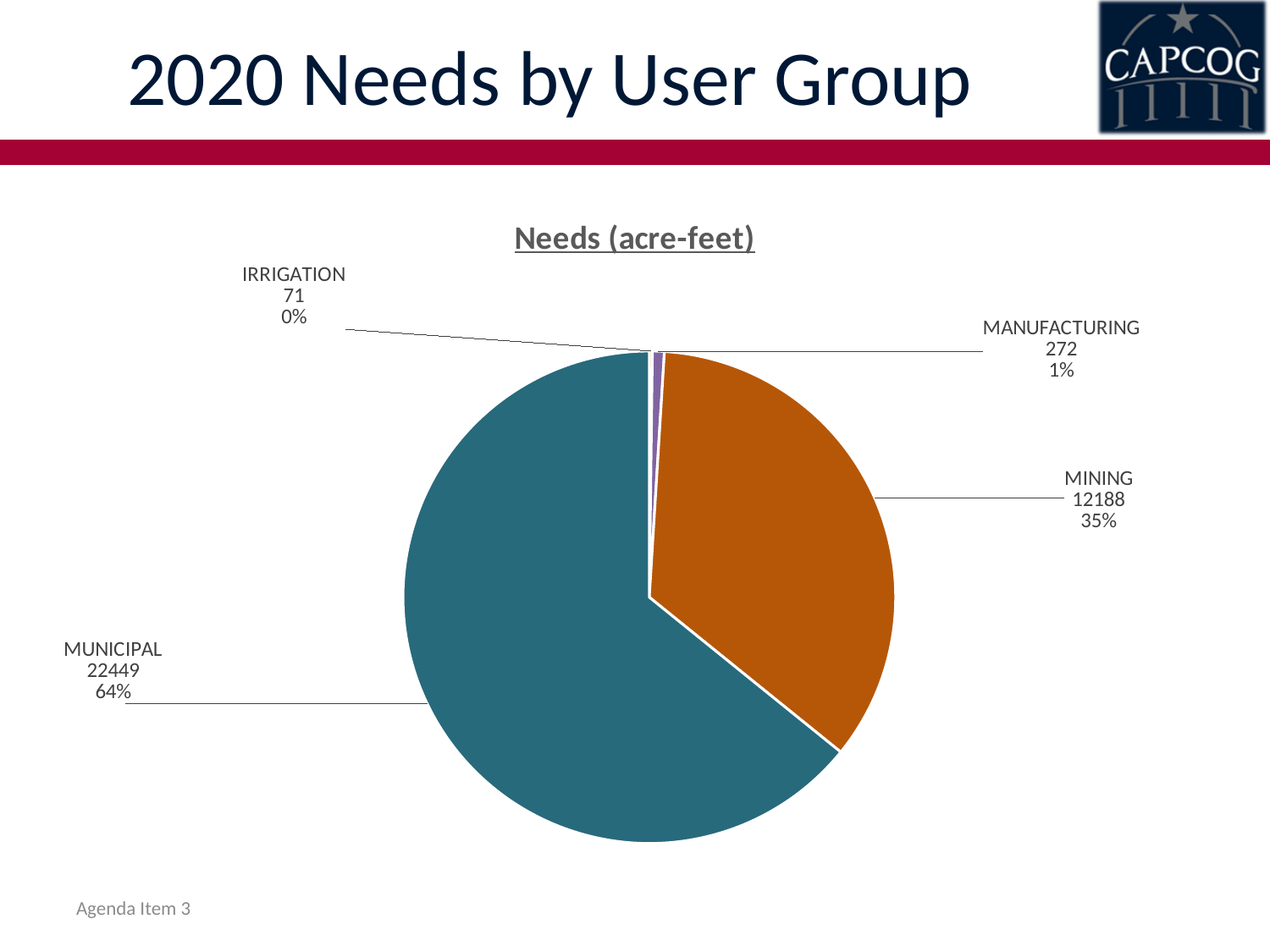
How many user groups are shown in the pie chart? 4 What is the value for MUNICIPAL in the Needs (acre-feet) pie chart? 22449 What percentage share of needs does MUNICIPAL account for? 64% What is the value for MANUFACTURING in the Needs (acre-feet) pie chart? 272 Which user group has the smallest share of needs in the pie chart? IRRIGATION What is the value for MINING in the Needs (acre-feet) pie chart? 12188 What is the difference between the MUNICIPAL and MINING values in the pie chart? 10261 What type of chart is shown on the slide? Pie chart What percentage share of needs does MINING account for? 35% What is the value for IRRIGATION in the Needs (acre-feet) pie chart? 71 Which is larger, the value for MANUFACTURING or the value for IRRIGATION? MANUFACTURING Which user group has the largest share of needs in the pie chart? MUNICIPAL